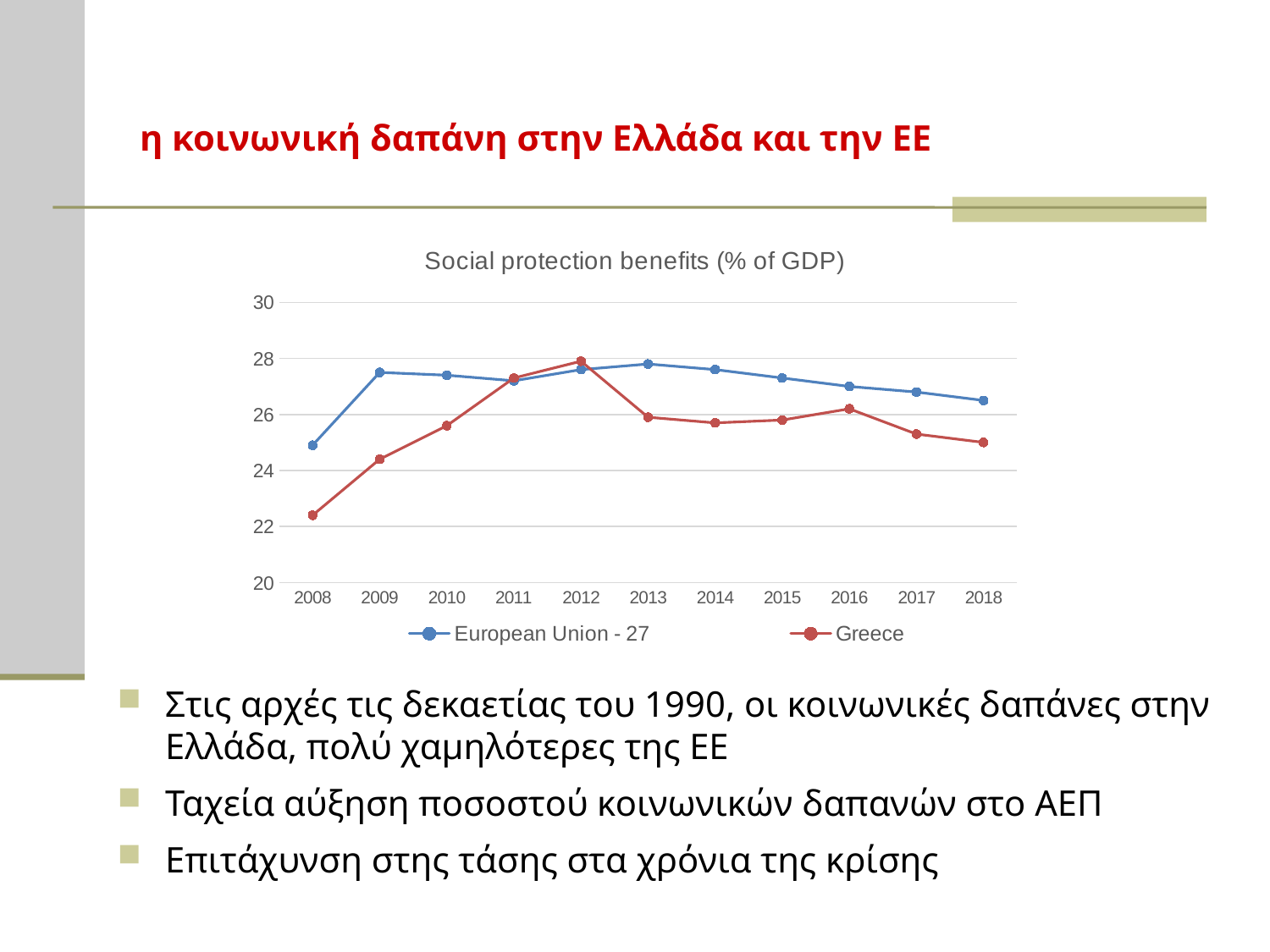
Is the value for Greece in 2012 greater or less than 26? greater In which year does the European Union - 27 series have its lowest value? 2008 What kind of chart is shown on the slide? Line chart What is the title of the chart? Social protection benefits (% of GDP) In which year does the Greece series have its lowest value? 2008 How many series does the chart legend list? 2 Is the value for European Union - 27 in 2018 greater or less than 26? greater In 2013, which series has the higher value, European Union - 27 or Greece? European Union - 27 How many years are plotted along the x axis of the chart? 11 Is the value for Greece in 2008 greater or less than 24? less In which year does the Greece series reach its highest value? 2012 Does the Greece series rise or fall from 2012 to 2018? Fall